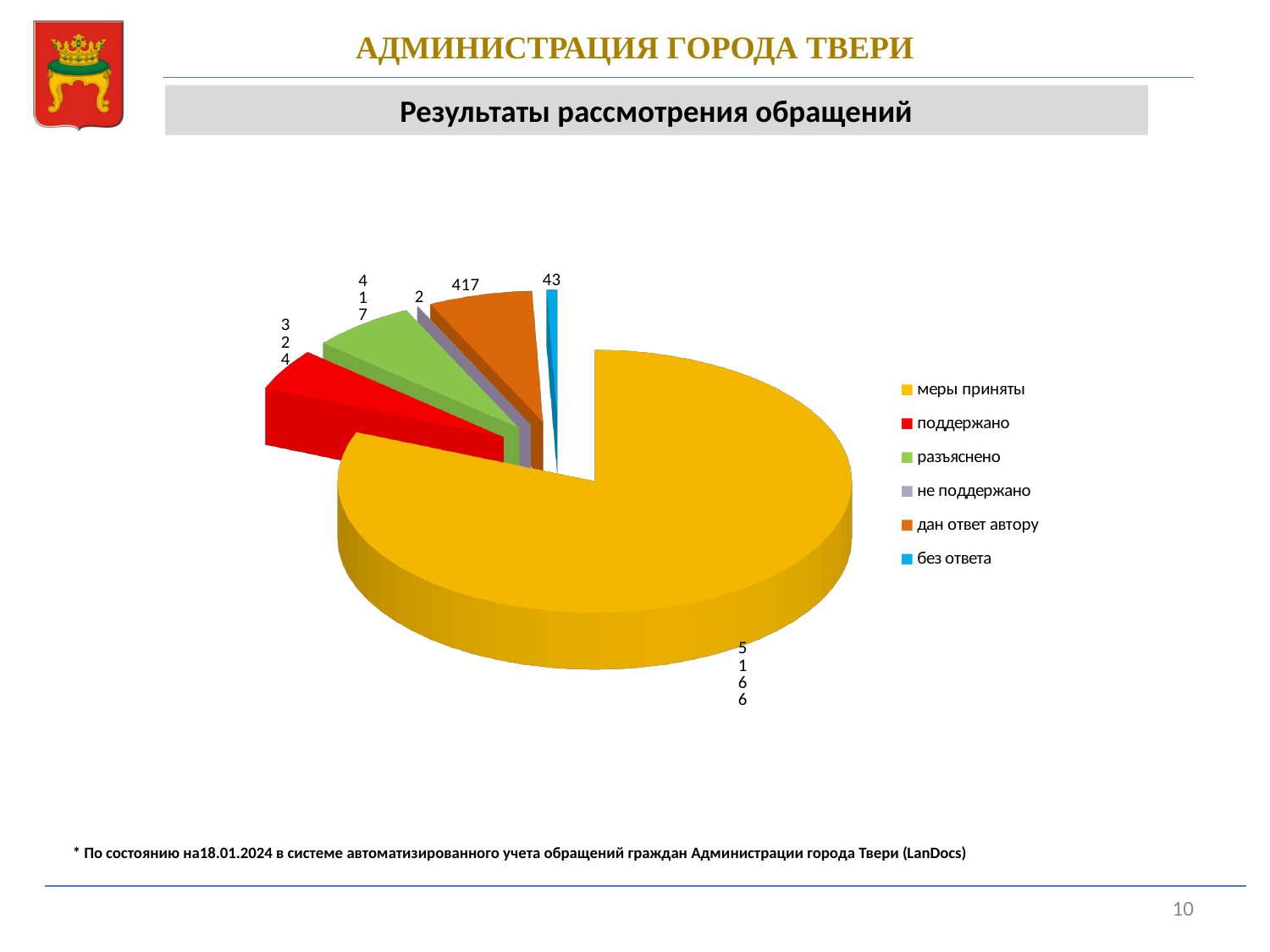
What is the value for 'меры приняты'? 5166 Which is larger, 'поддержано' or 'без ответа'? поддержано What is the value for 'не поддержано'? 2 What is the difference between 'меры приняты' and 'поддержано'? 4842 What is the value for 'поддержано'? 324 What is the title of the chart section on the slide? Результаты рассмотрения обращений What is the value for 'дан ответ автору'? 417 What is the value for 'без ответа'? 43 What kind of chart is shown on the slide? pie chart Which category has the largest slice of the pie? меры приняты Which category has the smallest slice of the pie? не поддержано How many categories does the legend of the pie chart list? 6